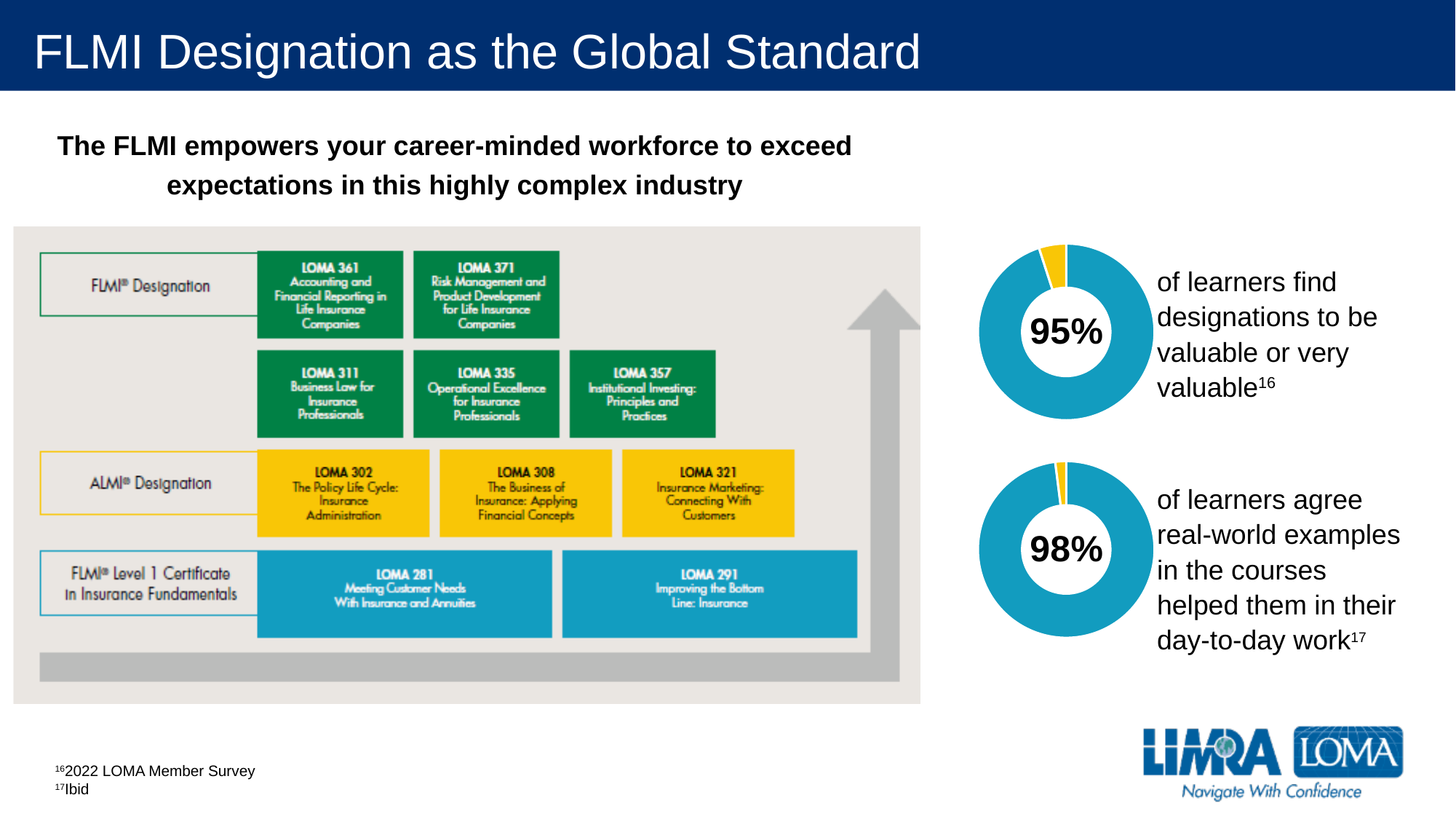
In the upper donut chart, what share of the ring is not covered by the 95% segment? 5% What kind of chart is the upper chart on the right side of the slide? donut chart Which donut chart shows the larger percentage, the upper one (designations valuable) or the lower one (real-world examples helped)? the lower one (98%) What colour is the small slice in the donut charts? yellow In the lower donut chart, what percentage of learners agree real-world examples in the courses helped them in their day-to-day work? 98% Which donut chart shows the lower percentage, the upper one or the lower one? the upper one (95%) In the upper donut chart, what percentage of learners find designations to be valuable or very valuable? 95% How many donut charts are shown on the slide? 2 Is the value shown in the upper donut chart greater or less than 90%? greater What colour is the large segment in both donut charts? blue What is the difference between the percentage in the lower donut chart and the percentage in the upper donut chart? 3% What does the 98% in the lower donut chart represent? learners who agree real-world examples in the courses helped them in their day-to-day work